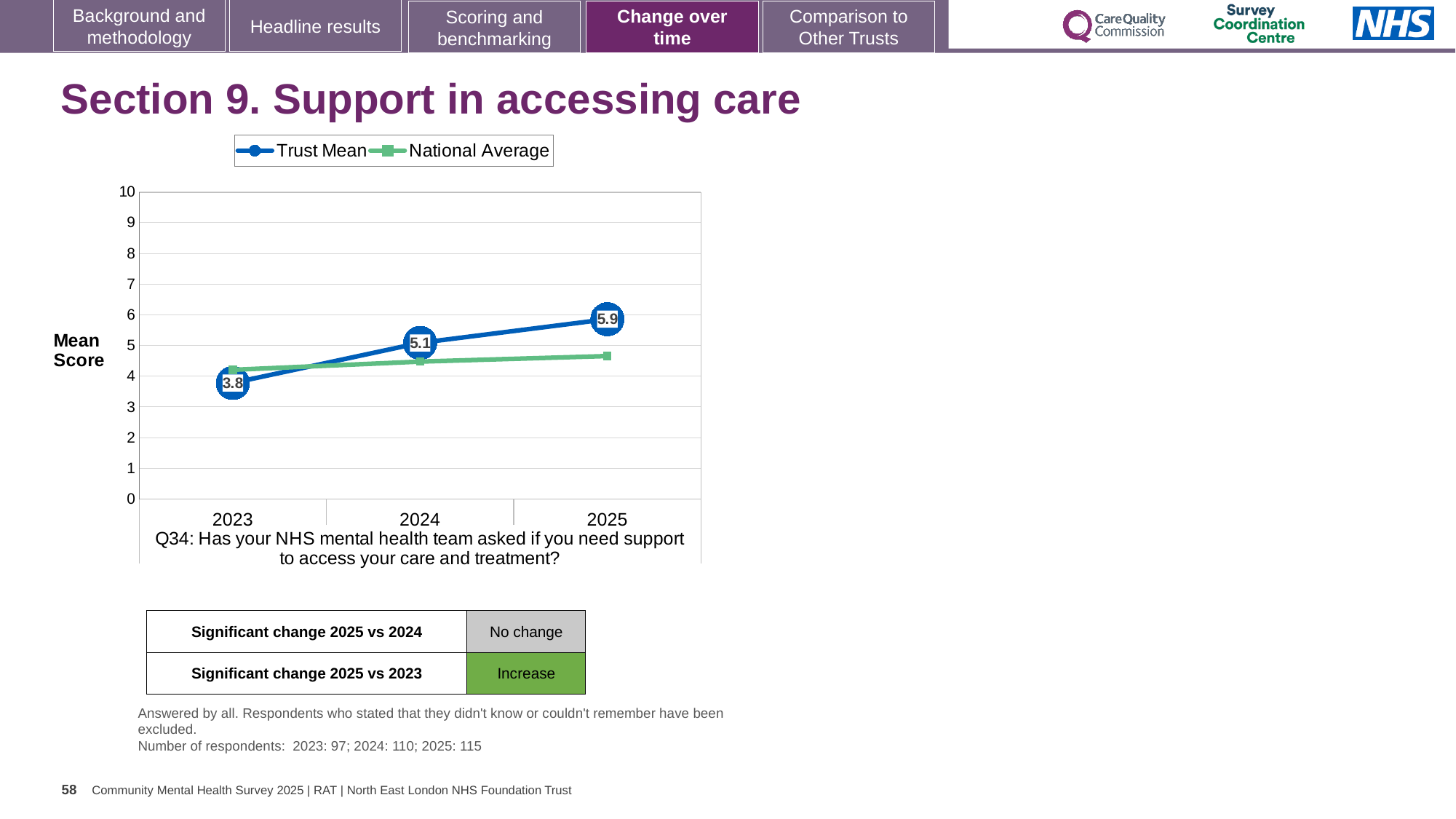
What kind of chart is shown on the slide? line chart How many series does the legend list? 2 What is the difference between the Trust Mean scores for 2025 and 2023? 2.1 What is the Trust Mean score for 2023? 3.8 What is the Trust Mean score for 2024? 5.1 Does the Trust Mean rise or fall from 2023 to 2025? rise What is the Trust Mean score for 2025? 5.9 Is the National Average value for 2025 greater or less than 5? less In which year is the Trust Mean score lowest? 2023 Which is larger, the Trust Mean score for 2024 or for 2025? 2025 How many years are shown on the x axis? 3 In which year is the Trust Mean score highest? 2025